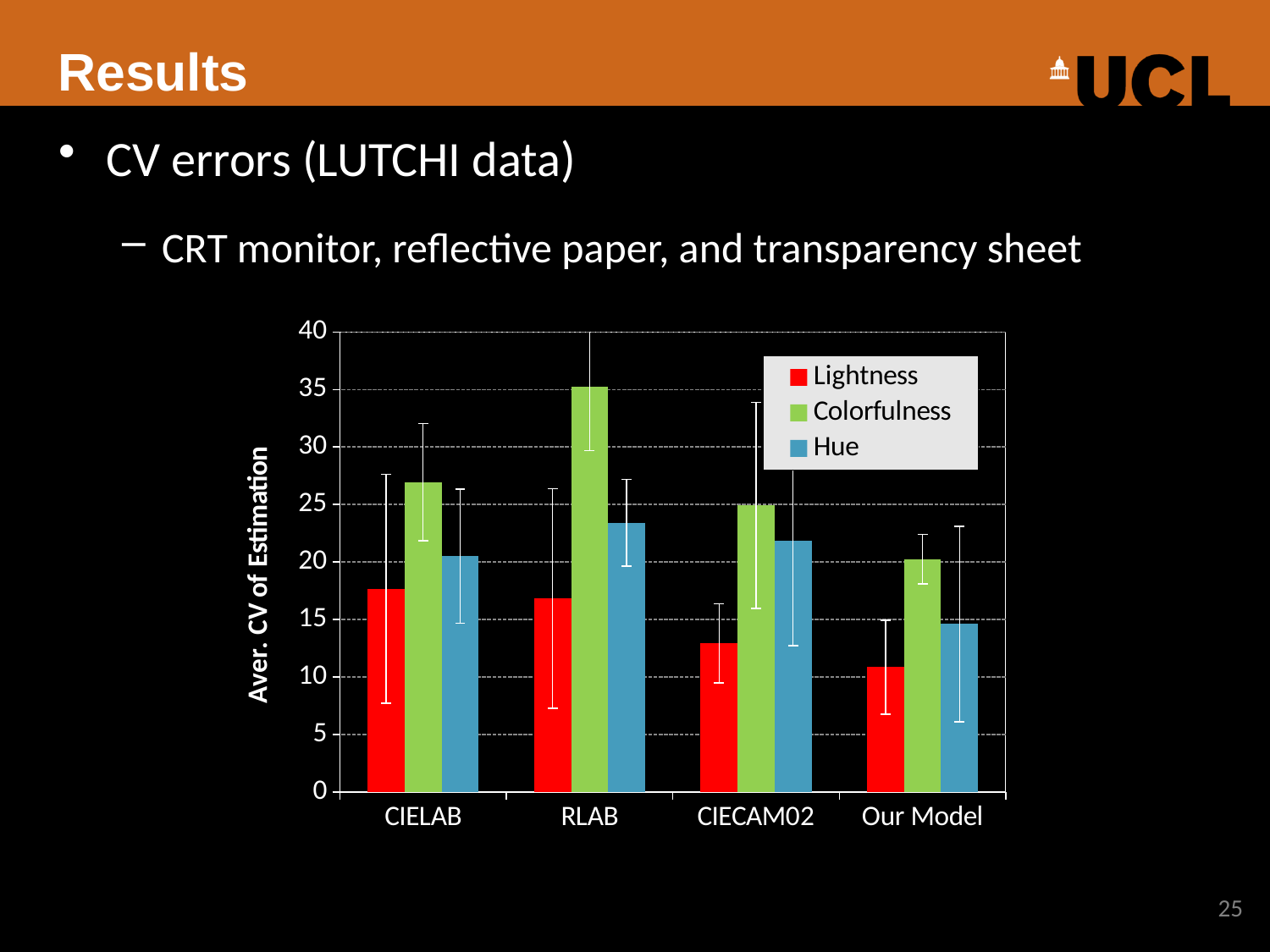
How many series does the chart's legend list? 3 What kind of chart is shown on the slide? bar chart Do the Lightness values rise or fall from CIELAB to Our Model along the x axis? fall What is the title of the chart's vertical axis? Aver. CV of Estimation Which series has the highest value for Our Model? Colorfulness How many categories are shown on the x axis of the chart? 4 Is the Lightness value for Our Model greater or less than 15? less Is the Colorfulness value for RLAB greater or less than 30? greater Which category has the highest Colorfulness value? RLAB Which has the larger Hue value, RLAB or Our Model? RLAB Which category has the lowest Lightness value? Our Model Is the Colorfulness value for Our Model greater or less than 25? less